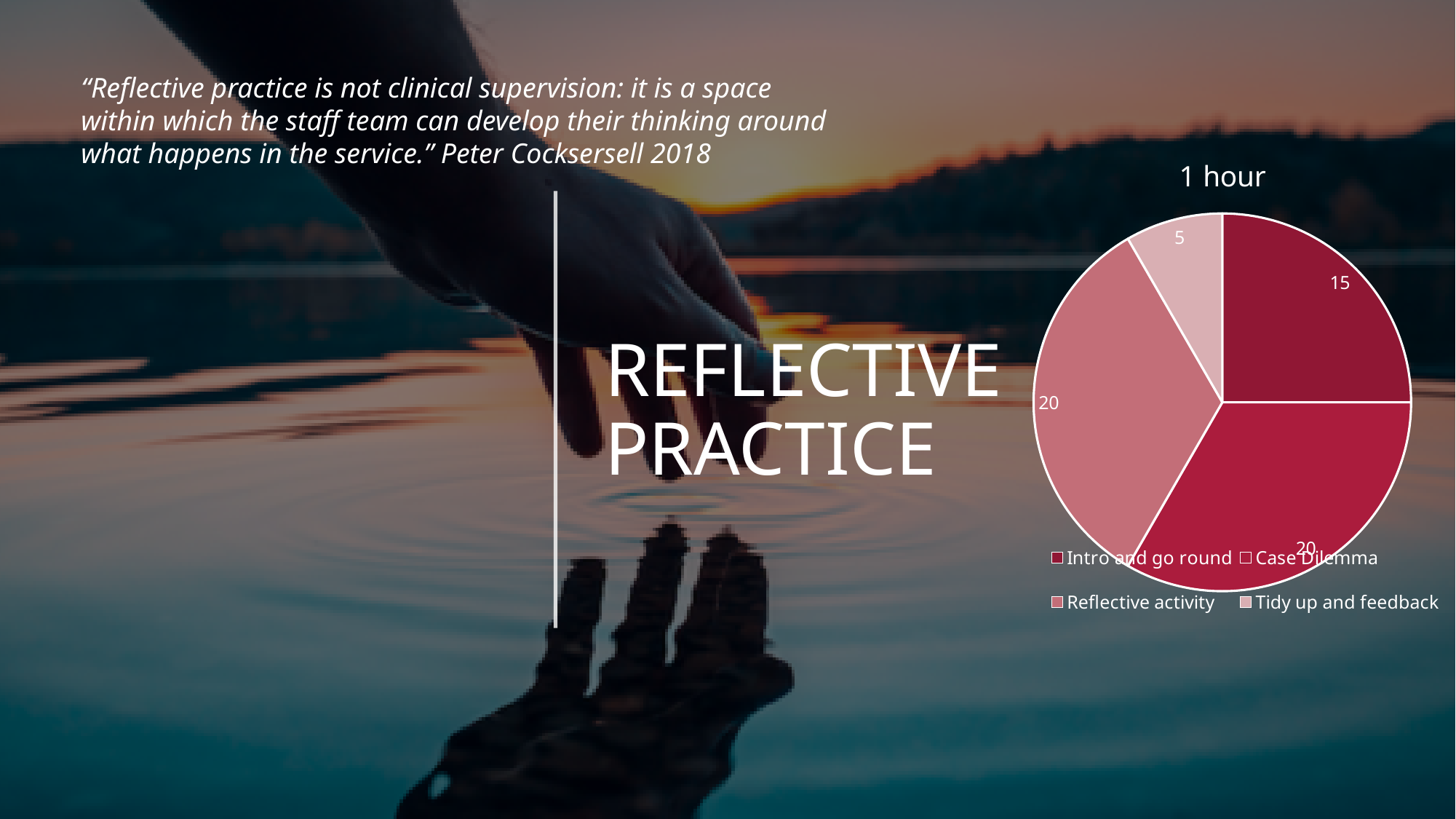
What type of chart is shown on the slide? Pie chart Which is larger, the value for Reflective activity or the value for Tidy up and feedback? Reflective activity What share of the pie does Intro and go round represent? 25% Which category has the smallest slice in the pie chart? Tidy up and feedback What is the value for Intro and go round in the pie chart? 15 What is the difference between the values for Intro and go round and Tidy up and feedback? 10 How many slices does the pie chart have? 4 What is the title of the pie chart? 1 hour What is the value for Tidy up and feedback in the pie chart? 5 What is the difference between the values for Case Dilemma and Intro and go round? 5 What is the value for Reflective activity in the pie chart? 20 What is the value for Case Dilemma in the pie chart? 20